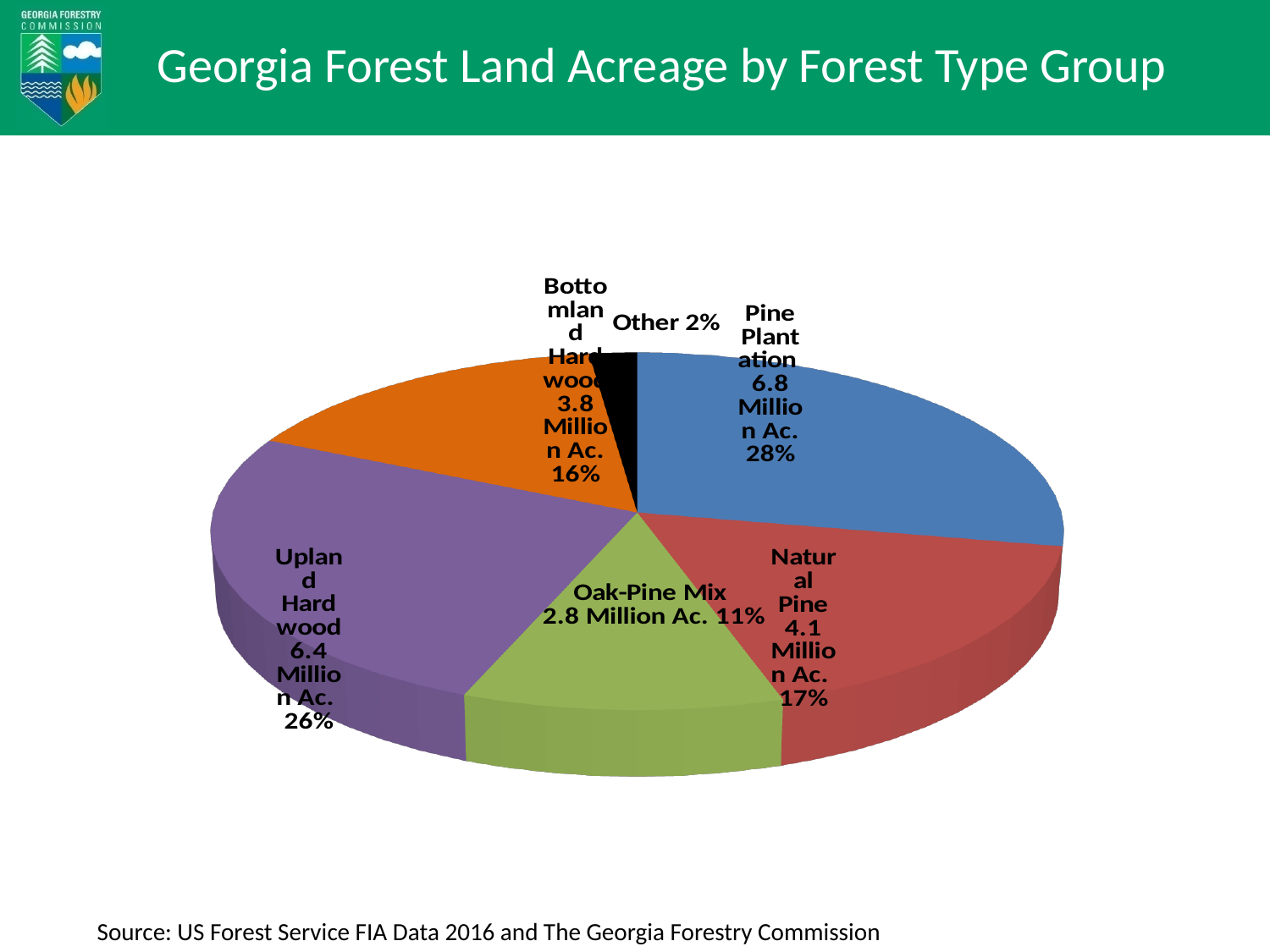
Which has more acreage, Natural Pine or Bottomland Hardwood? Natural Pine What share of the pie does Oak-Pine Mix represent? 11% Which forest type group has the largest share of the pie? Pine Plantation Which forest type group has the smallest share of the pie? Other What share of the pie does Pine Plantation represent? 28% How many acres of forest land are in the Upland Hardwood group? 6.4 Million Ac. What is the difference in percentage points between the Pine Plantation and Upland Hardwood shares? 2 percentage points What share of the pie does Bottomland Hardwood represent? 16% How many acres of forest land are in the Natural Pine group? 4.1 Million Ac. What kind of chart is shown on the slide? Pie chart How many slices does the pie chart have? 6 What is the title of the chart on the slide? Georgia Forest Land Acreage by Forest Type Group